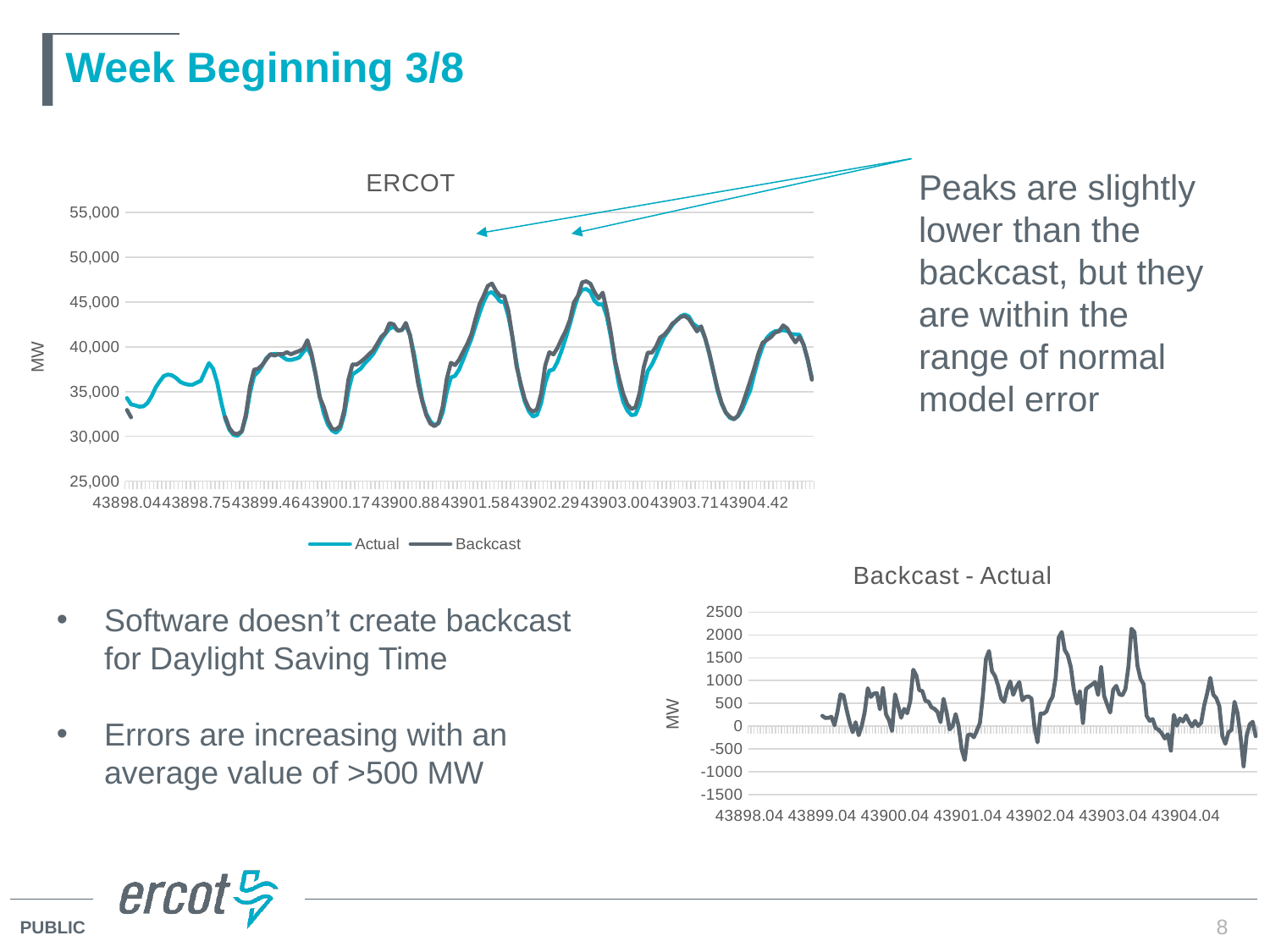
In the ERCOT chart, is the highest value of the Backcast series greater or less than 45,000? greater How many series does the legend of the ERCOT chart list? 2 What kind of chart is the Backcast - Actual chart? line chart What kind of chart is the ERCOT chart? line chart In the Backcast - Actual chart, is the lowest value greater or less than -500? less In the ERCOT chart, at the daily peaks, which series is higher, Actual or Backcast? Backcast In the ERCOT chart, is the highest value of either series greater or less than 50,000? less What is the y-axis label on the ERCOT chart? MW What are the two series named in the legend of the ERCOT chart? Actual and Backcast